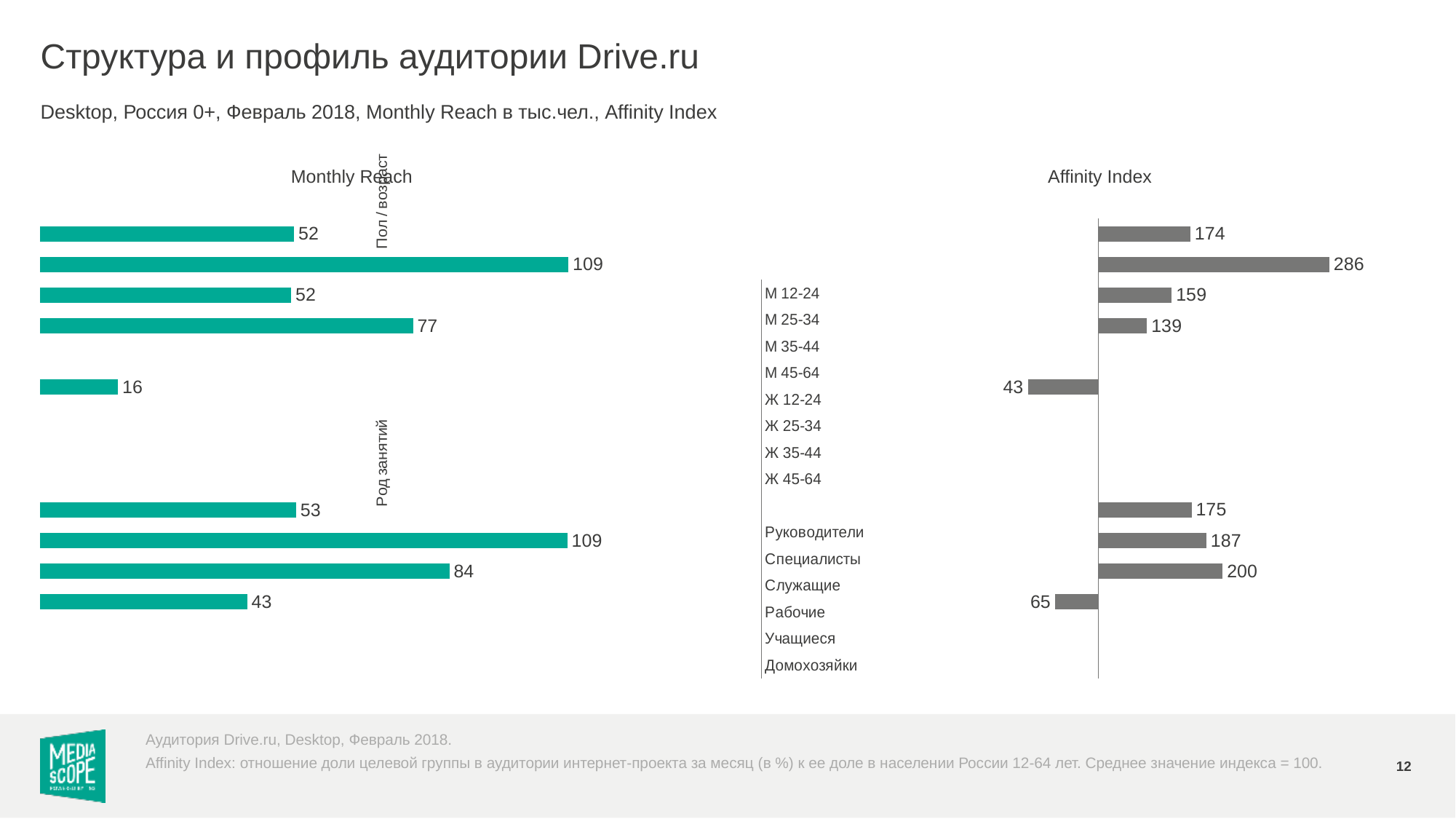
In the Affinity Index chart, what is the value of the top bar? 174 What kind of chart is the Monthly Reach chart on the left? bar chart In the Affinity Index chart, which is larger: the top bar (174) or the bottom bar (65)? the top bar (174) What is the title of the chart on the right side of the slide? Affinity Index In the Affinity Index chart, what is the highest value shown? 286 In the Monthly Reach chart, what is the highest value shown? 109 In the Affinity Index chart, what is the lowest value shown? 43 How many bars are plotted in the Monthly Reach chart? 9 In the Monthly Reach chart, what is the lowest value shown? 16 In the Monthly Reach chart, what is the value of the bottom bar? 43 In the Affinity Index chart, what is the difference between the highest value (286) and the lowest value (43)? 243 In the Affinity Index chart, what is the value of the bottom bar? 65